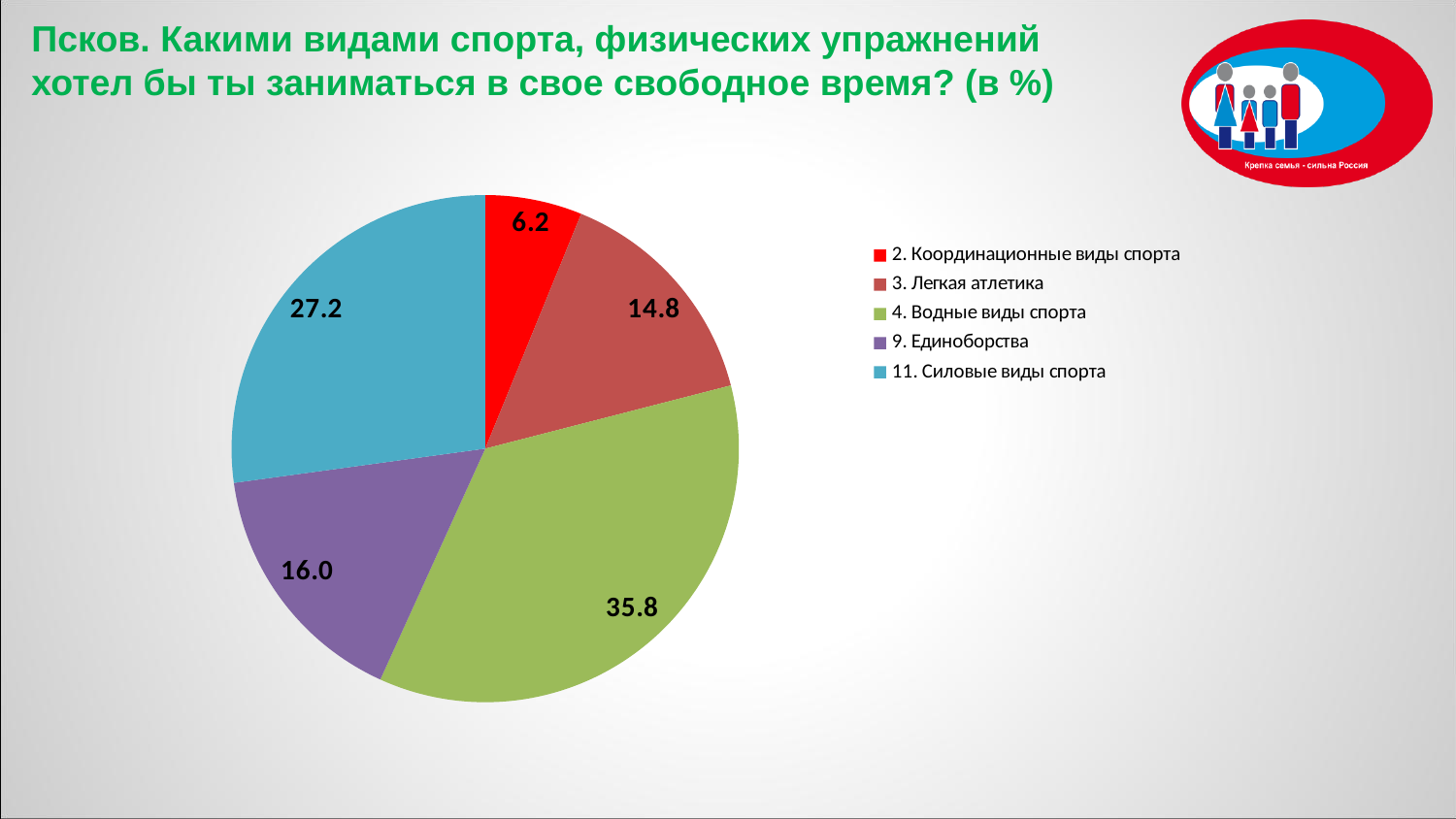
What is the value for "9. Единоборства"? 16.0 What is the value for "2. Координационные виды спорта"? 6.2 Which category has the smallest slice of the pie? 2. Координационные виды спорта What is the difference between the values for "4. Водные виды спорта" and "11. Силовые виды спорта"? 8.6 What is the value for "11. Силовые виды спорта"? 27.2 What is the difference between the values for "3. Легкая атлетика" and "2. Координационные виды спорта"? 8.6 What is the value for "4. Водные виды спорта"? 35.8 What colour is the slice for "11. Силовые виды спорта"? blue Which category has the largest slice of the pie? 4. Водные виды спорта How many categories does the pie chart have? 5 What type of chart is shown on the slide? pie chart Which is larger: the value for "9. Единоборства" or the value for "3. Легкая атлетика"? 9. Единоборства